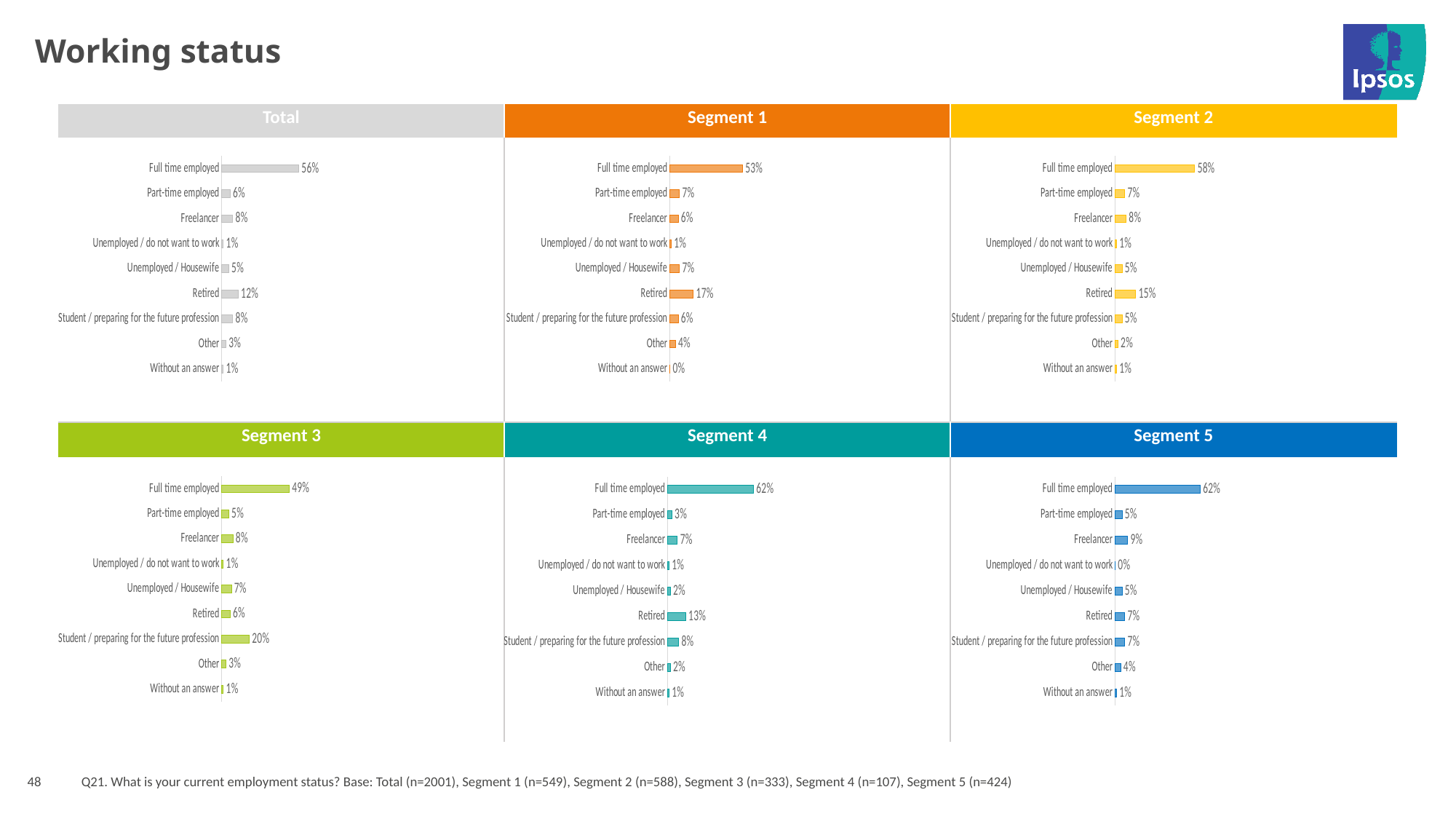
In the Segment 3 chart, what is the value for Student / preparing for the future profession? 20% In the Segment 2 chart, what is the value for Retired? 15% In the Total chart, what is the value for Full time employed? 56% How many charts are shown on the slide? 6 In the Segment 2 chart, which category has the highest value? Full time employed In the Segment 1 chart, what is the value for Retired? 17% How many categories does the Segment 3 chart show? 9 In the Segment 3 chart, what is the difference between Full time employed and Student / preparing for the future profession? 29% In the Segment 4 chart, what is the difference between Full time employed and Retired? 49% In the Segment 1 chart, what is the value for Without an answer? 0% What kind of chart is the Total chart? Bar chart In the Segment 5 chart, which is larger, Freelancer or Retired? Freelancer